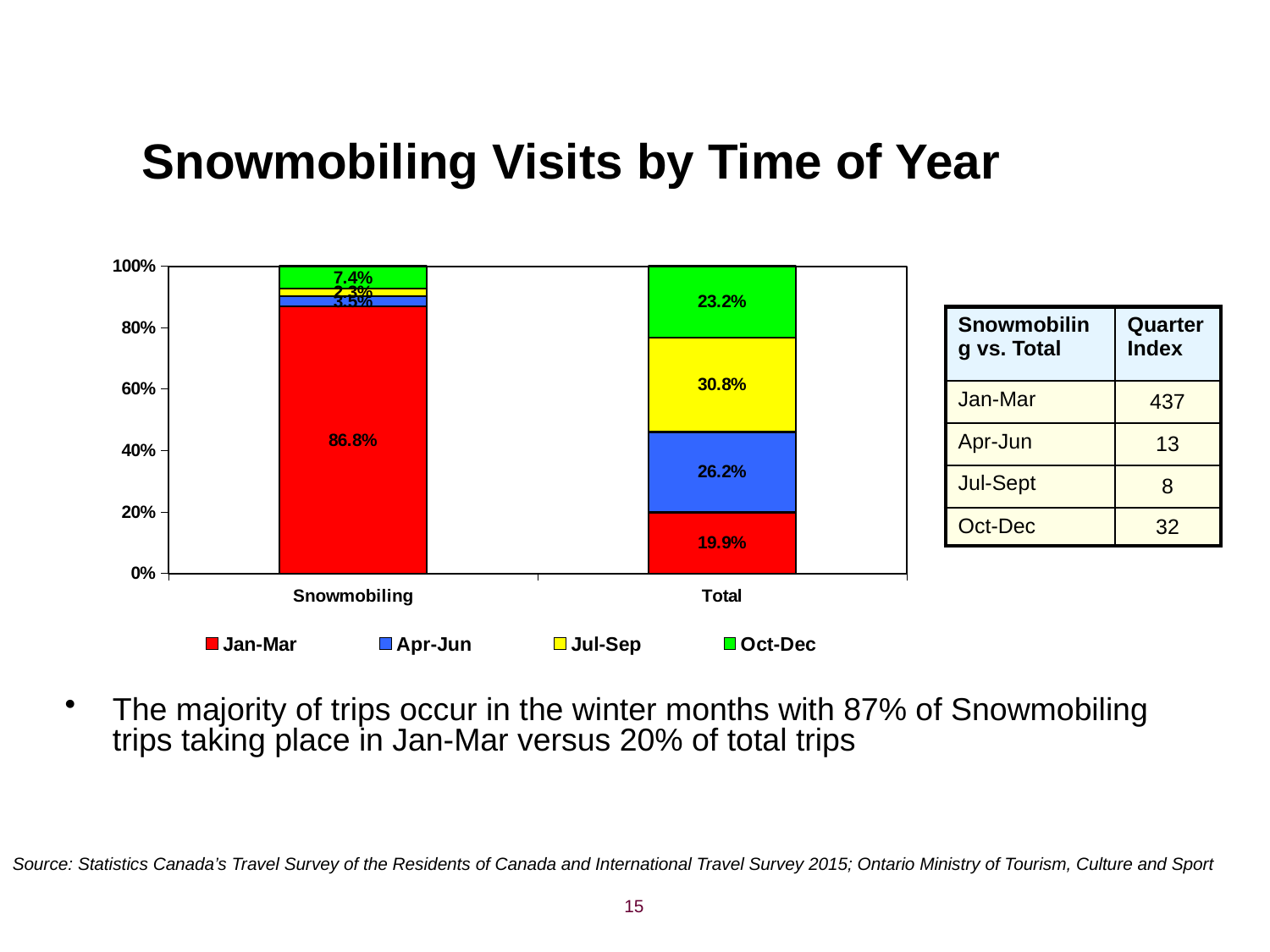
What kind of chart is shown on the slide? Stacked bar chart How many percentage points higher is the Jan-Mar share for Snowmobiling than for Total? 66.9 percentage points What percentage of Total visits occur in Jan-Mar? 19.9% Which quarter has the largest share of the Total bar? Jul-Sep What is the Oct-Dec share of the Total bar? 23.2% Which quarter has the smallest share of the Total bar? Jan-Mar How many series does the legend list? 4 What is the Jul-Sep share of the Total bar? 30.8% How many categories are shown on the x axis? 2 What is the Apr-Jun share of the Total bar? 26.2% What percentage of Snowmobiling visits occur in Jan-Mar? 86.8% What is the Oct-Dec share of the Snowmobiling bar? 7.4%